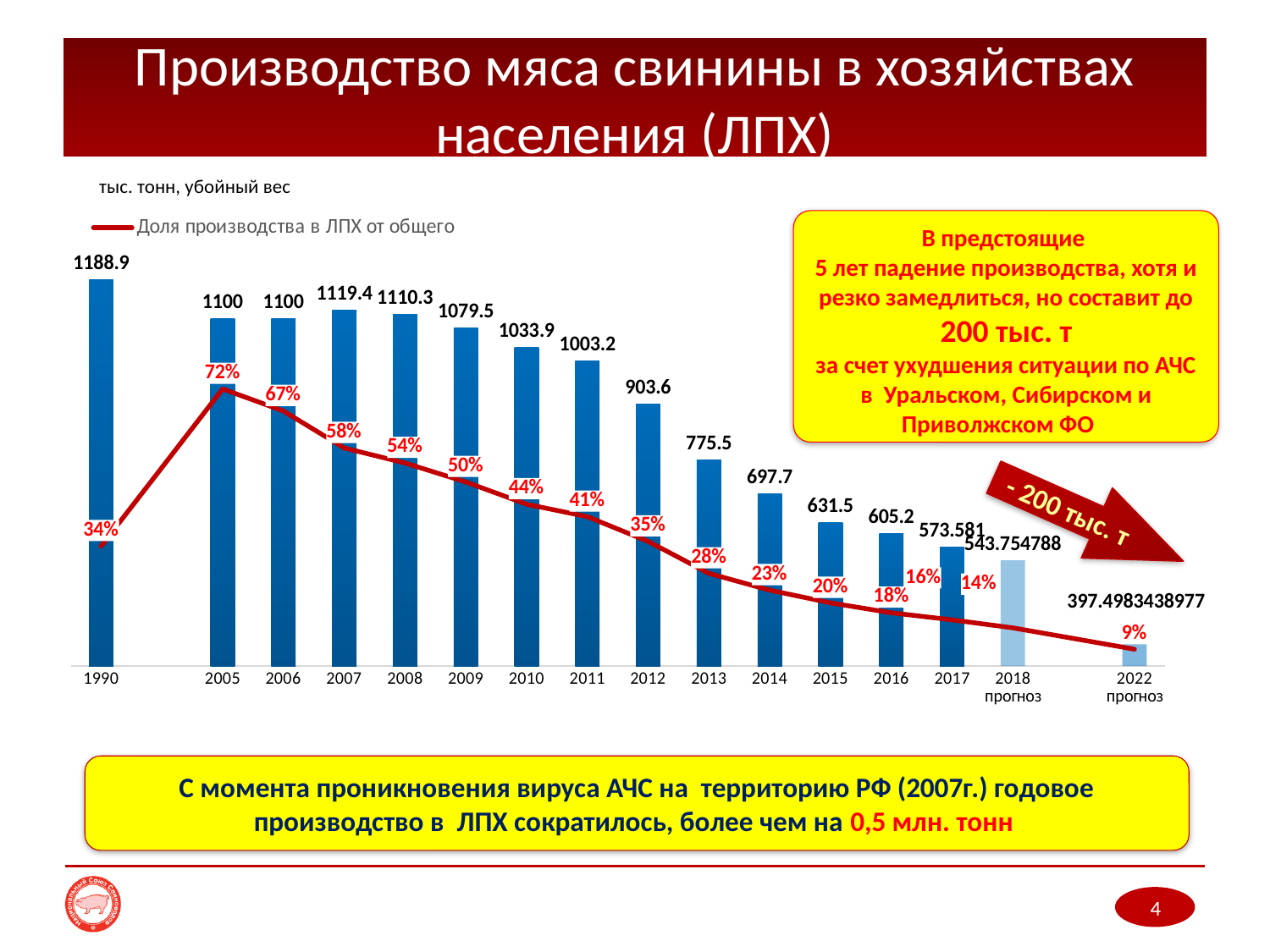
Which is larger, the production value for 2007 or for 2008? 2007 What is the production value shown for 1990? 1188.9 Which category has the lowest production bar? 2022 прогноз What share of total production is shown for the 2022 прогноз point? 9% What share of total production (Доля производства в ЛПХ от общего) is shown for 2005? 72% What is the difference between the production values for 2013 and 2014? 77.8 What is the production value shown for 2012? 903.6 How many categories are shown on the x axis? 16 Which year has the highest production bar? 1990 What is the name of the line series shown in the legend? Доля производства в ЛПХ от общего Do the production bars rise or fall from 2005 to 2022 прогноз? Fall What kind of chart is shown on the slide? Combined bar and line chart